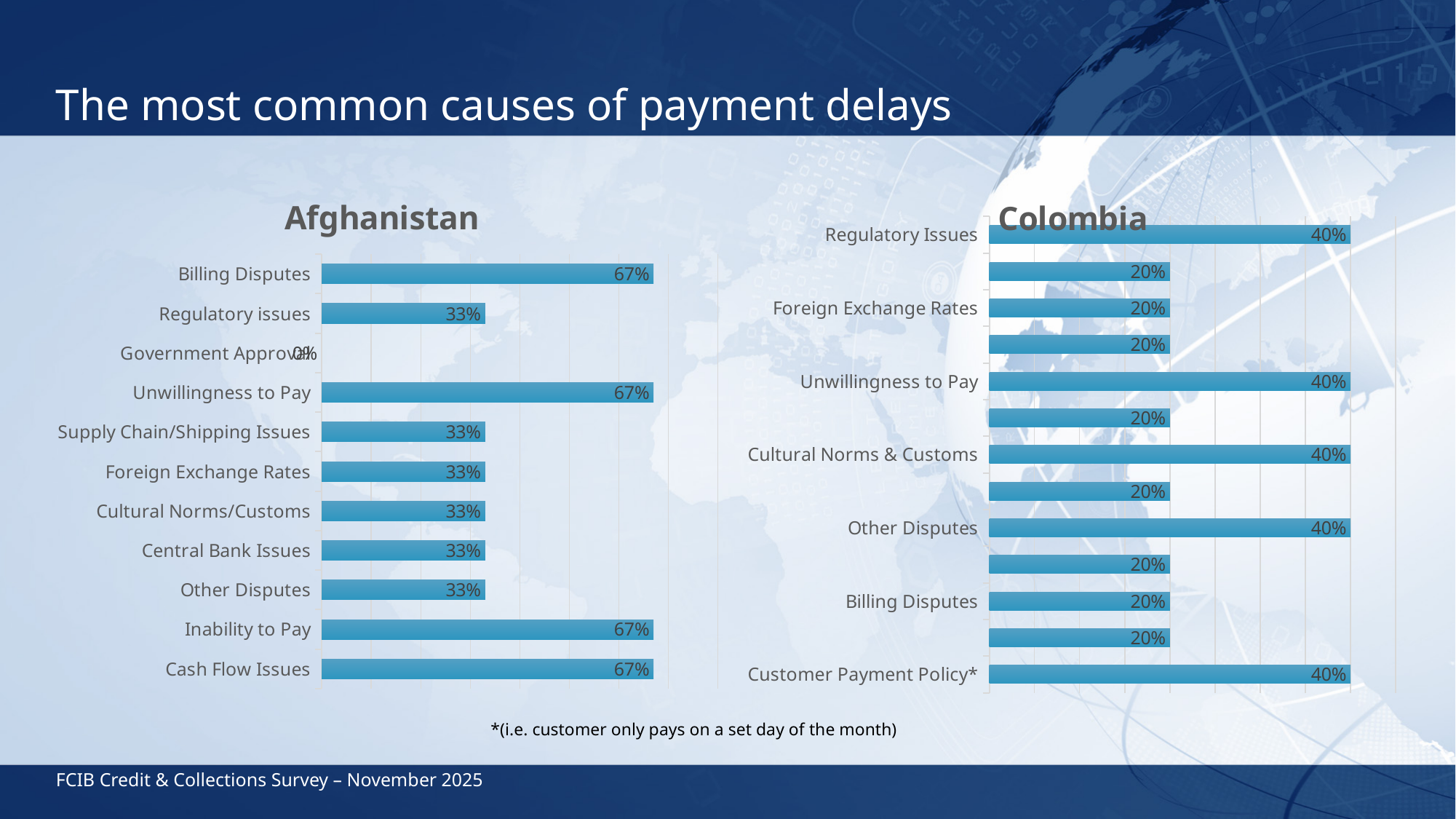
In the Colombia chart, what is the value for Billing Disputes? 20% How many categories are shown in the Afghanistan chart? 11 In the Afghanistan chart, what is the difference between Cash Flow Issues and Central Bank Issues? 34% What is the title of the slide? The most common causes of payment delays In the Afghanistan chart, which category has the lowest value? Government Approval In the Afghanistan chart, what is the value for Billing Disputes? 67% In the Colombia chart, what is the difference between Customer Payment Policy* and Foreign Exchange Rates? 20% In the Colombia chart, which is larger: Unwillingness to Pay or Foreign Exchange Rates? Unwillingness to Pay In the Afghanistan chart, what is the value for Regulatory issues? 33% In the Colombia chart, what is the value for Regulatory Issues? 40% What kind of chart is the Afghanistan chart? Bar chart In the Afghanistan chart, which is larger: Inability to Pay or Other Disputes? Inability to Pay